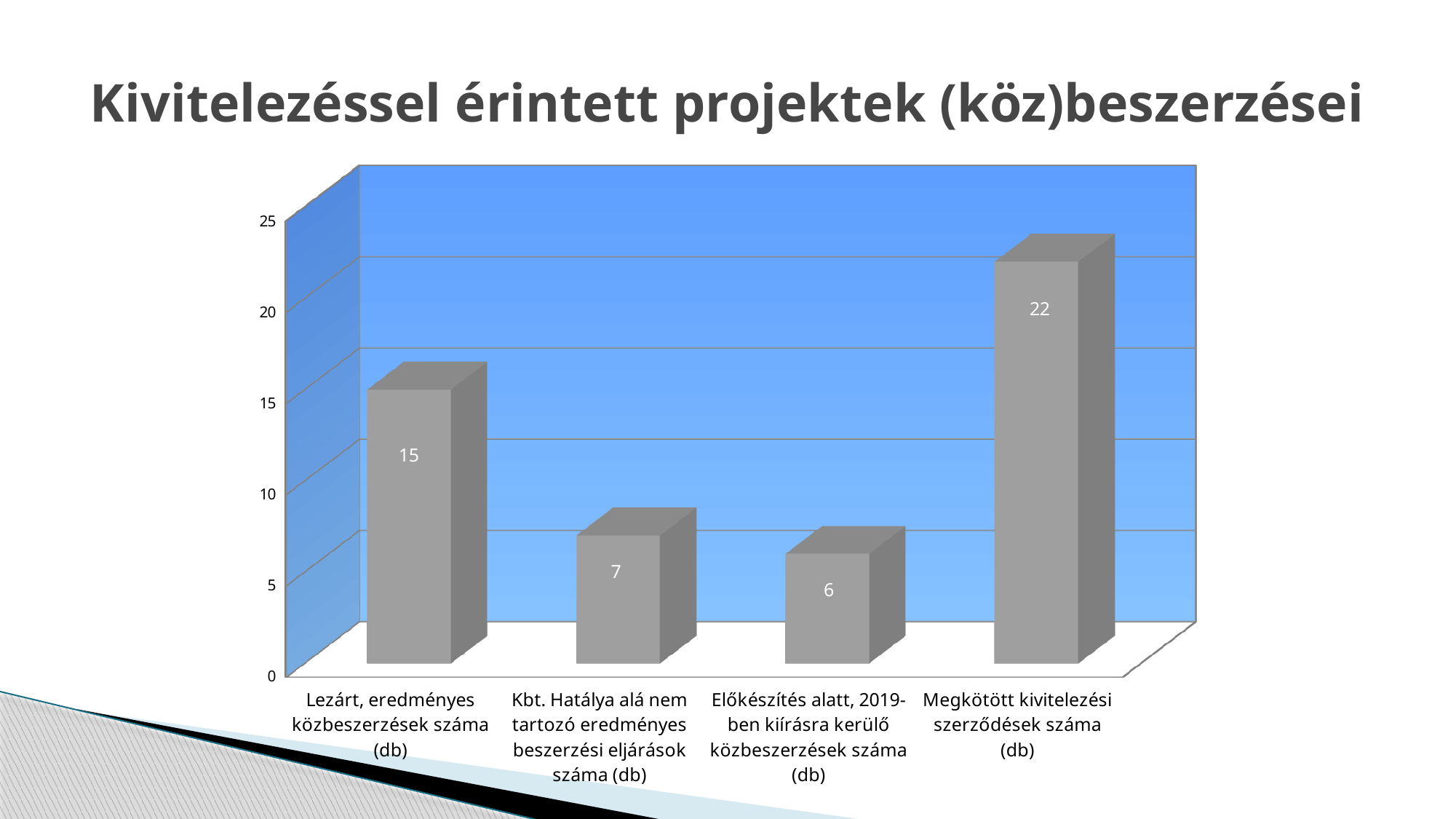
How many categories are shown in the chart? 4 What is the value for 'Kbt. Hatálya alá nem tartozó eredményes beszerzési eljárások száma (db)'? 7 Which category has the lowest value? Előkészítés alatt, 2019-ben kiírásra kerülő közbeszerzések száma (db) Is the value for 'Megkötött kivitelezési szerződések száma (db)' greater or less than 20? greater Which is larger: the value for 'Lezárt, eredményes közbeszerzések száma (db)' or 'Kbt. Hatálya alá nem tartozó eredményes beszerzési eljárások száma (db)'? Lezárt, eredményes közbeszerzések száma (db) What kind of chart is shown on the slide? bar chart What is the difference between the values for 'Megkötött kivitelezési szerződések száma (db)' and 'Lezárt, eredményes közbeszerzések száma (db)'? 7 What is the value for 'Megkötött kivitelezési szerződések száma (db)'? 22 What is the title of the slide? Kivitelezéssel érintett projektek (köz)beszerzései Which category has the highest value? Megkötött kivitelezési szerződések száma (db) What is the value for 'Lezárt, eredményes közbeszerzések száma (db)'? 15 What is the value for 'Előkészítés alatt, 2019-ben kiírásra kerülő közbeszerzések száma (db)'? 6